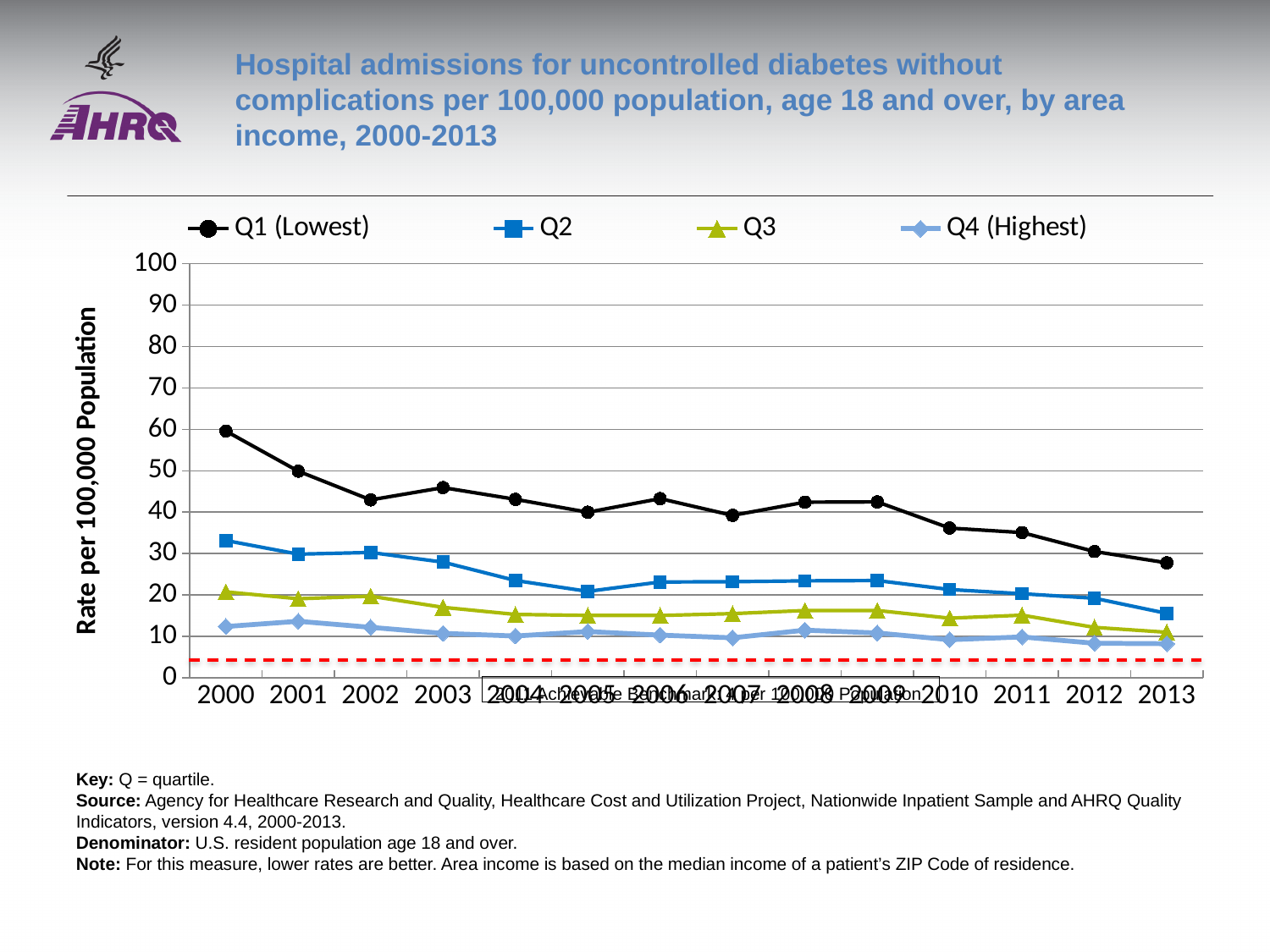
Is the value for Q1 (Lowest) in 2000 greater or less than 50? greater What kind of chart is shown on the slide? Line chart Is the value for Q2 in 2013 greater or less than 20? less What is the first year shown on the x axis? 2000 Is the value for Q4 (Highest) in 2013 greater or less than 10? less How many series does the legend list? 4 Does the rate for Q1 (Lowest) rise or fall from 2000 to 2013? Fall How many years are plotted along the x axis? 14 What is the title of the y axis? Rate per 100,000 Population Which series has the lowest rate in 2013? Q4 (Highest) Which is larger in 2000, the value for Q1 (Lowest) or the value for Q4 (Highest)? Q1 (Lowest) Which series has the highest rate in 2000? Q1 (Lowest)